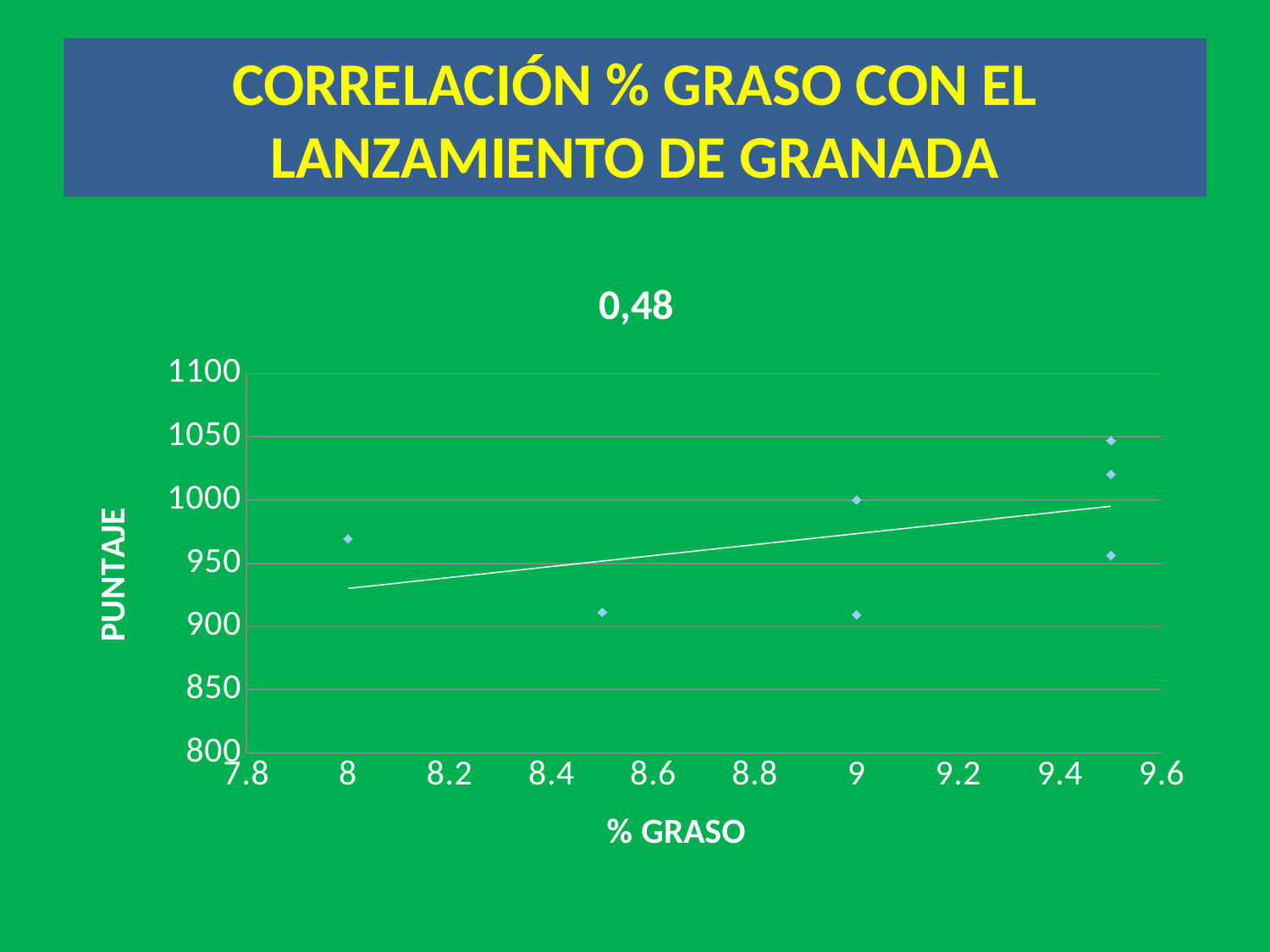
How many data points are plotted at % GRASO 9.5? 3 Is the PUNTAJE value of the highest point on the chart greater or less than 1000? greater What kind of chart is shown on the slide? scatter chart Is the PUNTAJE value of the lowest point at % GRASO 9 greater or less than 950? less What is the label of the vertical axis? PUNTAJE Does the trend line rise or fall as % GRASO increases? rises Is the trend line's value at % GRASO 8 greater or less than 950? less How many data points are plotted on the chart? 7 What is the title shown above the chart? 0,48 How many data points are plotted at % GRASO 9? 2